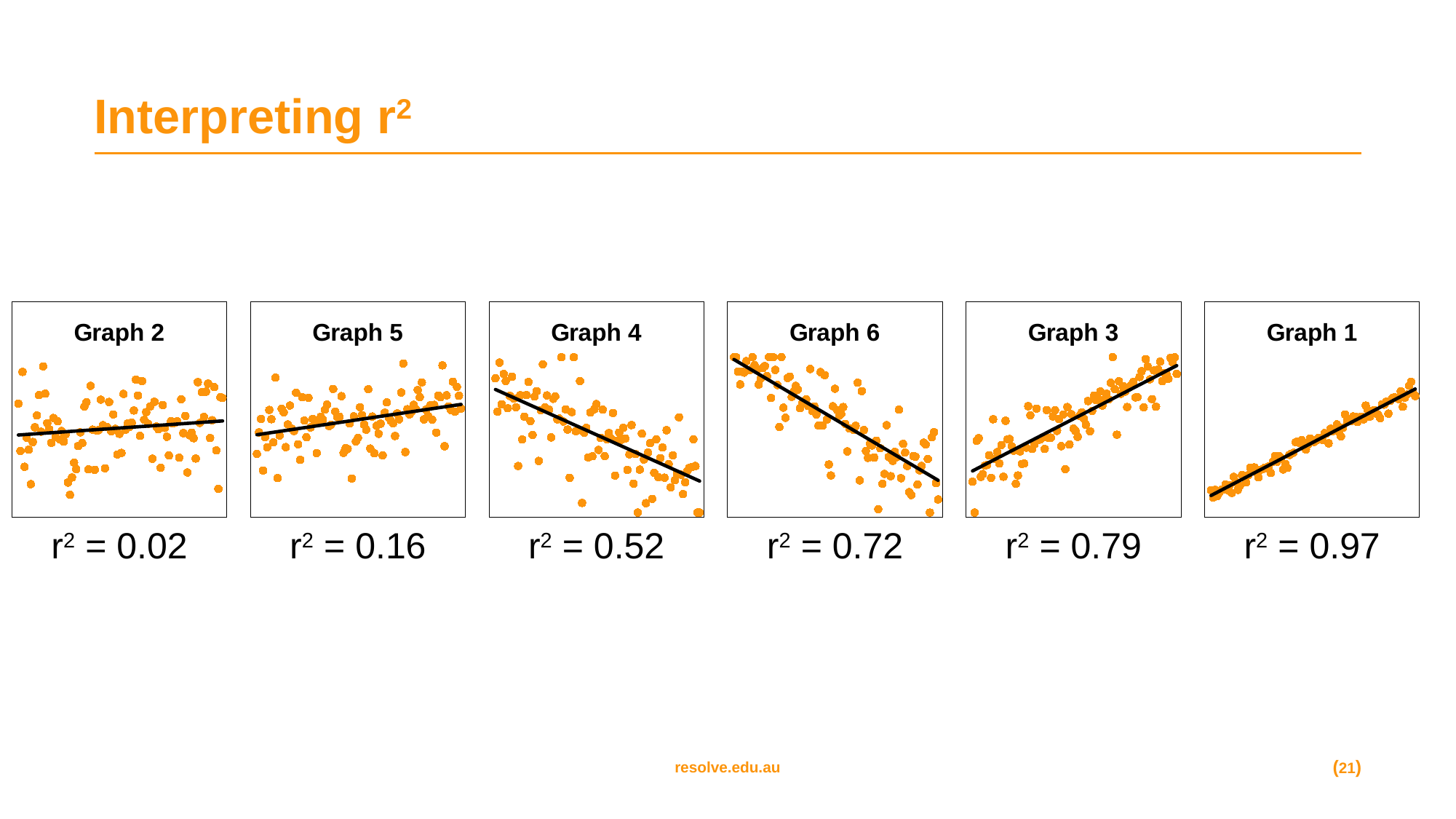
In Graph 6, do the points rise or fall from left to right? fall What is the r² value printed under Graph 4? 0.52 How many graphs are shown on the slide? 6 Which graph has the lowest r² value? Graph 2 Which has the larger r² value, Graph 5 or Graph 4? Graph 4 What is the r² value printed under Graph 2? 0.02 What is the difference between the r² values of Graph 1 and Graph 6? 0.25 What is the title of the slide? Interpreting r² In Graph 3, does the trend line rise or fall from left to right? rise What kind of chart is Graph 1? scatter plot What is the r² value printed under Graph 3? 0.79 Which graph has the highest r² value? Graph 1